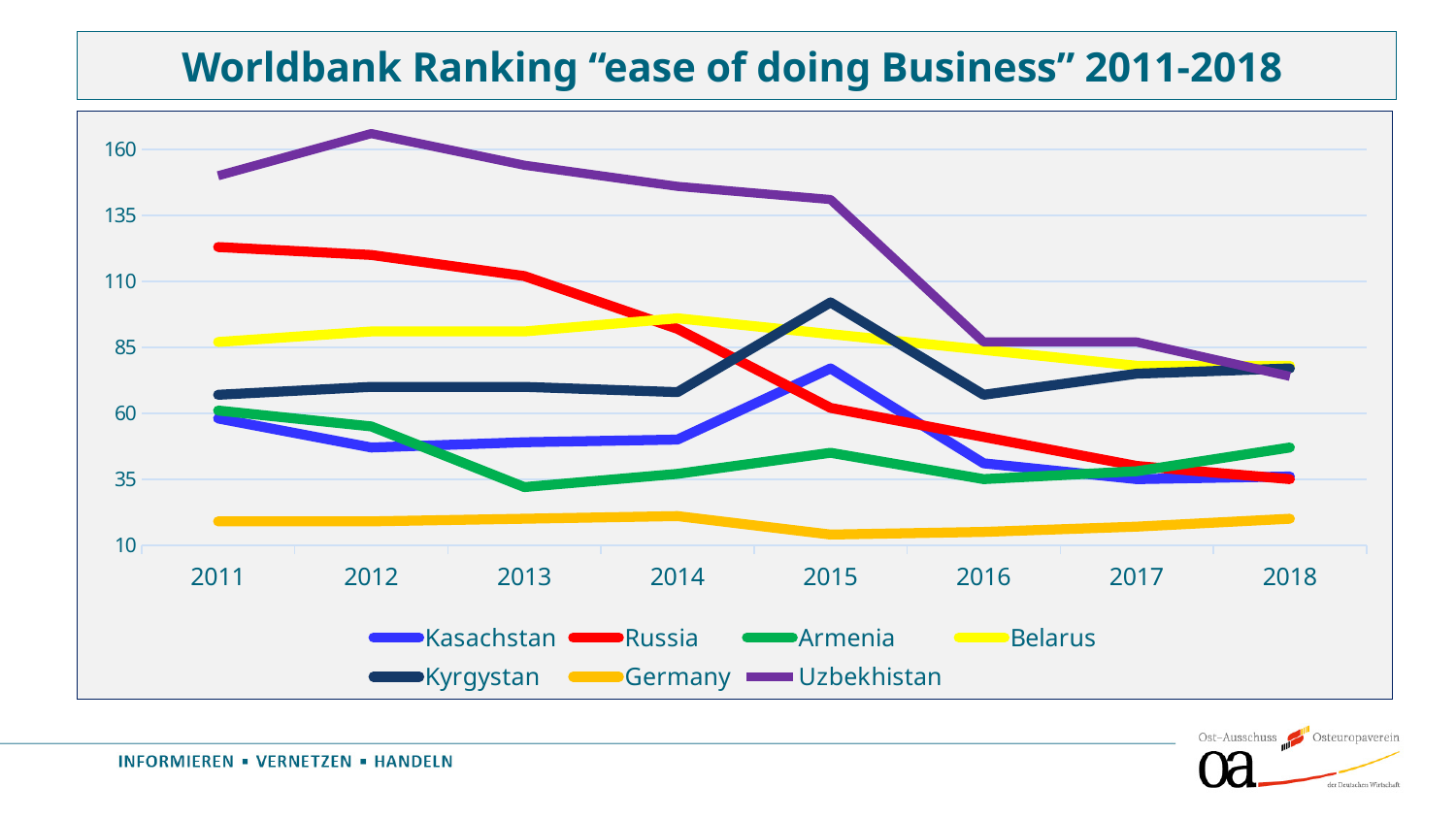
Does the value for Russia rise or fall from 2011 to 2018? fall How many years are plotted along the x axis? 8 Which country has the highest value in 2012? Uzbekhistan Is the value for Germany in 2011 greater or less than 35? less Is the value for Uzbekhistan in 2012 greater or less than 160? greater Is the value for Russia in 2011 greater or less than 110? greater How many series does the legend list? 7 Which is larger in 2016, the value for Kyrgystan or the value for Kasachstan? Kyrgystan What is the title of the chart? Worldbank Ranking "ease of doing Business" 2011-2018 What kind of chart is shown on the slide? line chart Which country has the lowest value in 2018? Germany